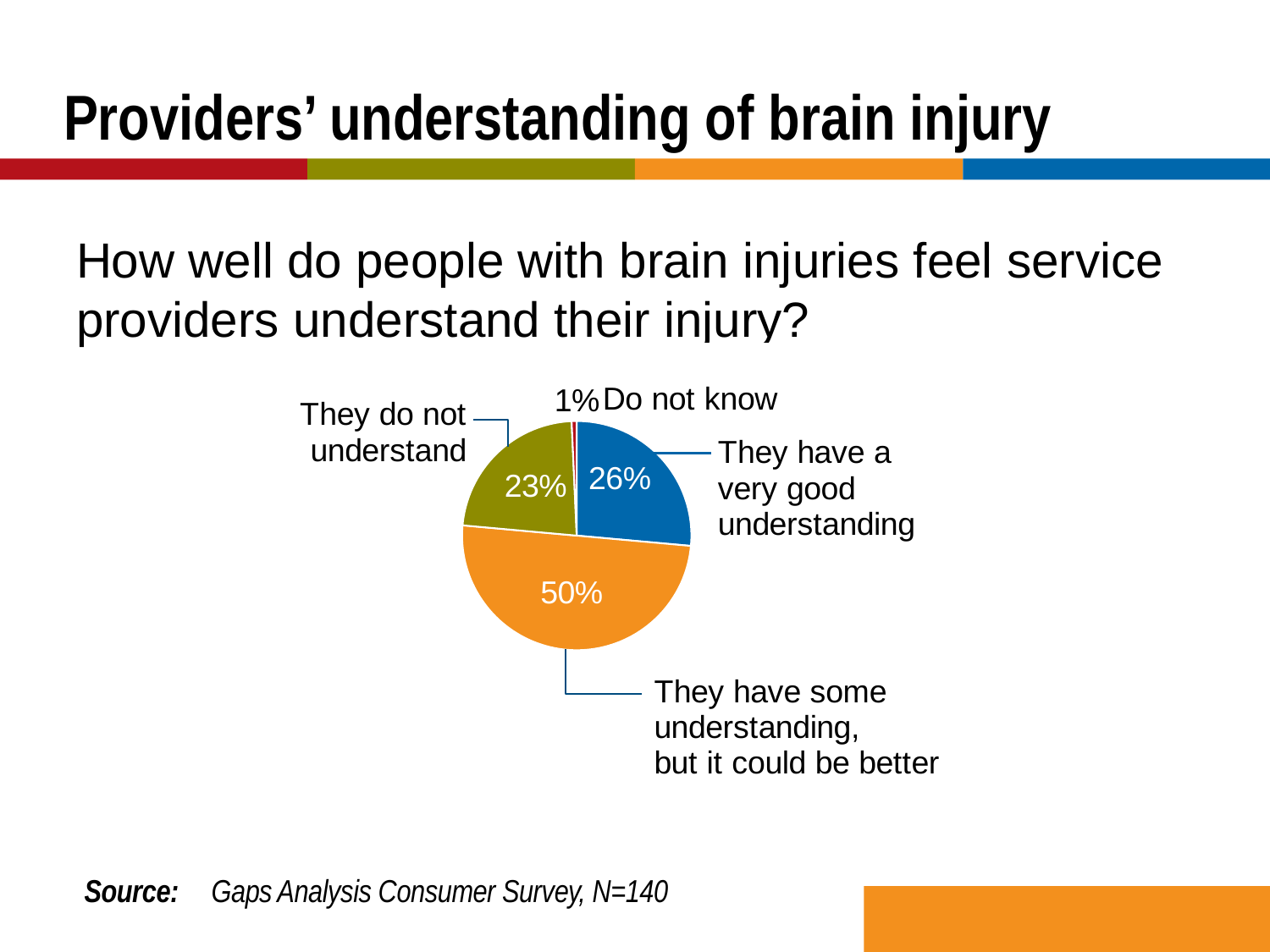
Which response has the smallest share of the pie? Do not know What colour is the slice for 'They have some understanding, but it could be better'? orange What percentage of respondents said providers do not understand? 23% What percentage of respondents said providers have some understanding, but it could be better? 50% What is the difference in percentage points between 'They have some understanding, but it could be better' and 'They do not understand'? 27 Which response has the largest share of the pie? They have some understanding, but it could be better What percentage of respondents said providers have a very good understanding? 26% What kind of chart is shown on the slide? pie chart What percentage of respondents answered 'Do not know'? 1% Which is larger: the share for 'They have a very good understanding' or the share for 'They do not understand'? They have a very good understanding What is the difference in percentage points between 'They have a very good understanding' and 'They do not understand'? 3 How many slices does the pie chart have? 4